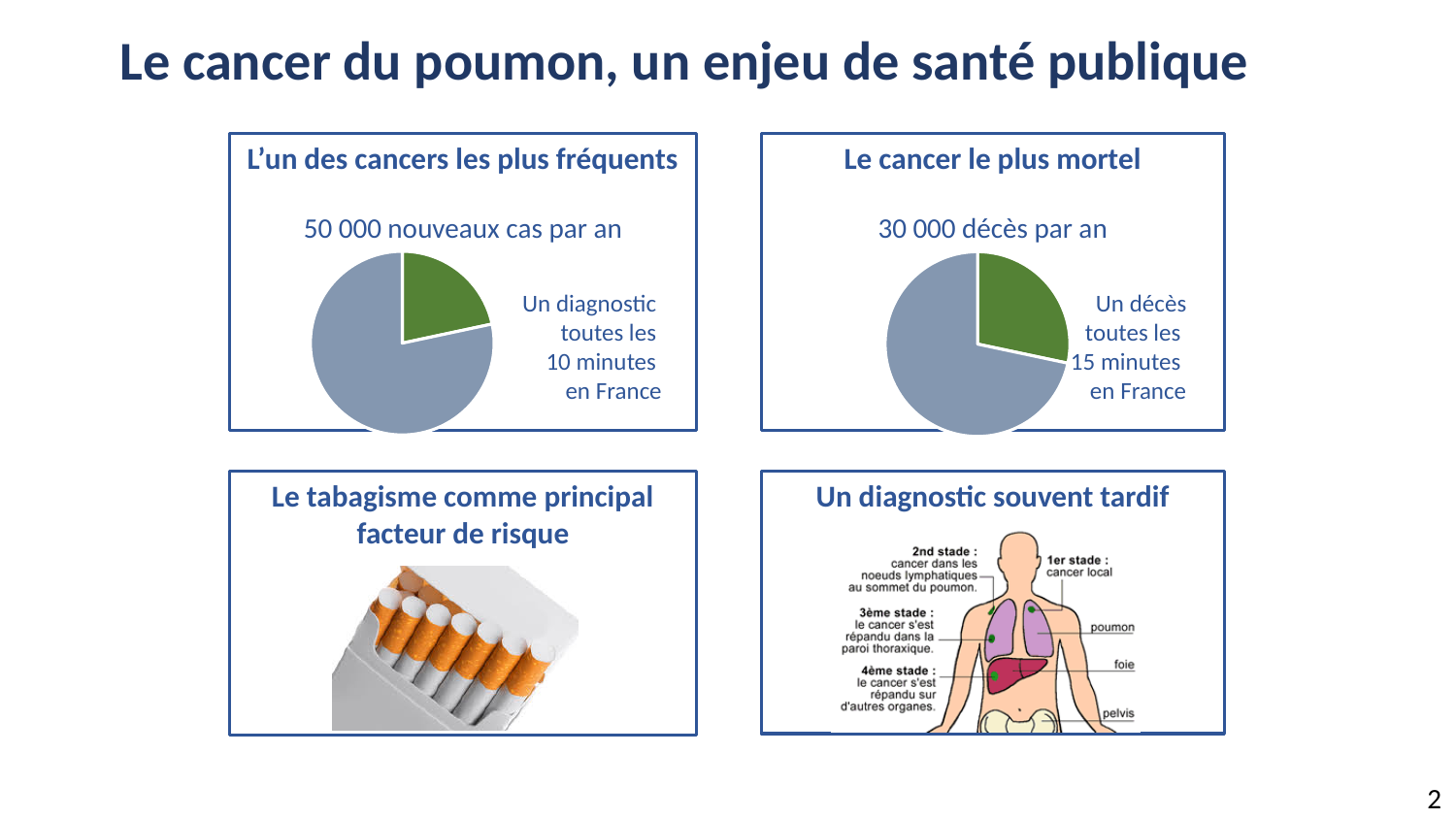
In the pie chart under "L'un des cancers les plus fréquents", which slice is larger, the green one or the grey-blue one? the grey-blue one What kind of chart is shown in the box titled "Le cancer le plus mortel"? pie chart How many slices does the pie chart in the box "L'un des cancers les plus fréquents" have? 2 In the pie chart under "Le cancer le plus mortel", is the green slice more or less than half of the pie? less In the pie chart under "Le cancer le plus mortel", which slice is larger, the green one or the grey-blue one? the grey-blue one What kind of chart is shown in the box titled "L'un des cancers les plus fréquents"? pie chart What text appears directly above the pie chart in the box "Le cancer le plus mortel"? 30 000 décès par an How many slices does the pie chart in the box "Le cancer le plus mortel" have? 2 What text appears directly above the pie chart in the box "L'un des cancers les plus fréquents"? 50 000 nouveaux cas par an